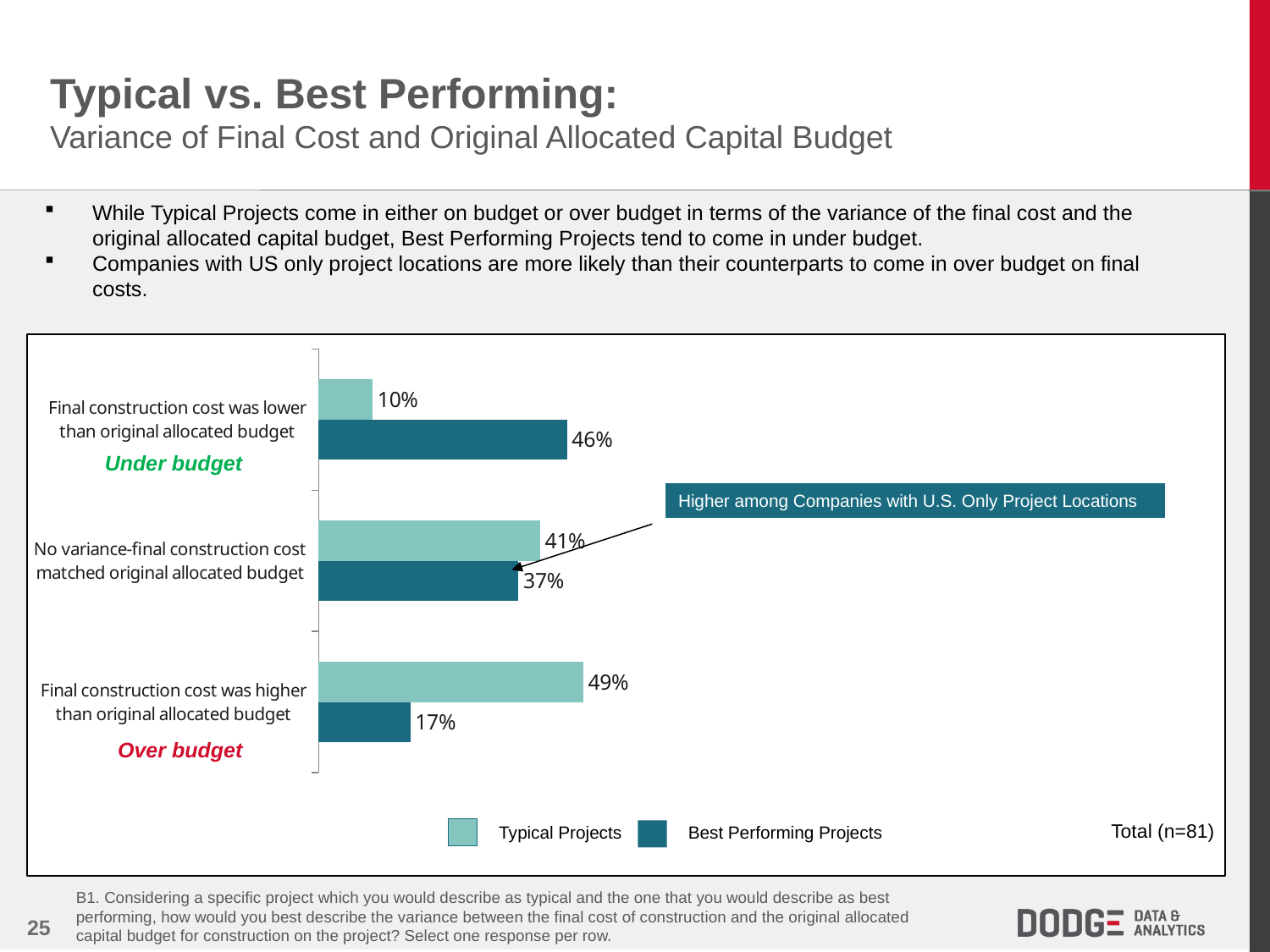
What percentage of Typical Projects had a final construction cost lower than the original allocated budget? 10% What percentage of Best Performing Projects had a final construction cost lower than the original allocated budget? 46% For 'No variance-final construction cost matched original allocated budget', which series has the larger value, Typical Projects or Best Performing Projects? Typical Projects What percentage of Best Performing Projects had a final construction cost higher than the original allocated budget? 17% Which category has the highest value for Typical Projects? Final construction cost was higher than original allocated budget What is the difference between Best Performing Projects and Typical Projects for 'Final construction cost was lower than original allocated budget'? 36 percentage points What is the total sample size shown next to the legend? n=81 Which category has the lowest value for Best Performing Projects? Final construction cost was higher than original allocated budget How many series does the legend list? 2 What kind of chart is shown on the slide? Bar chart How many categories are shown on the chart? 3 What percentage of Typical Projects had no variance between final construction cost and original allocated budget? 41%